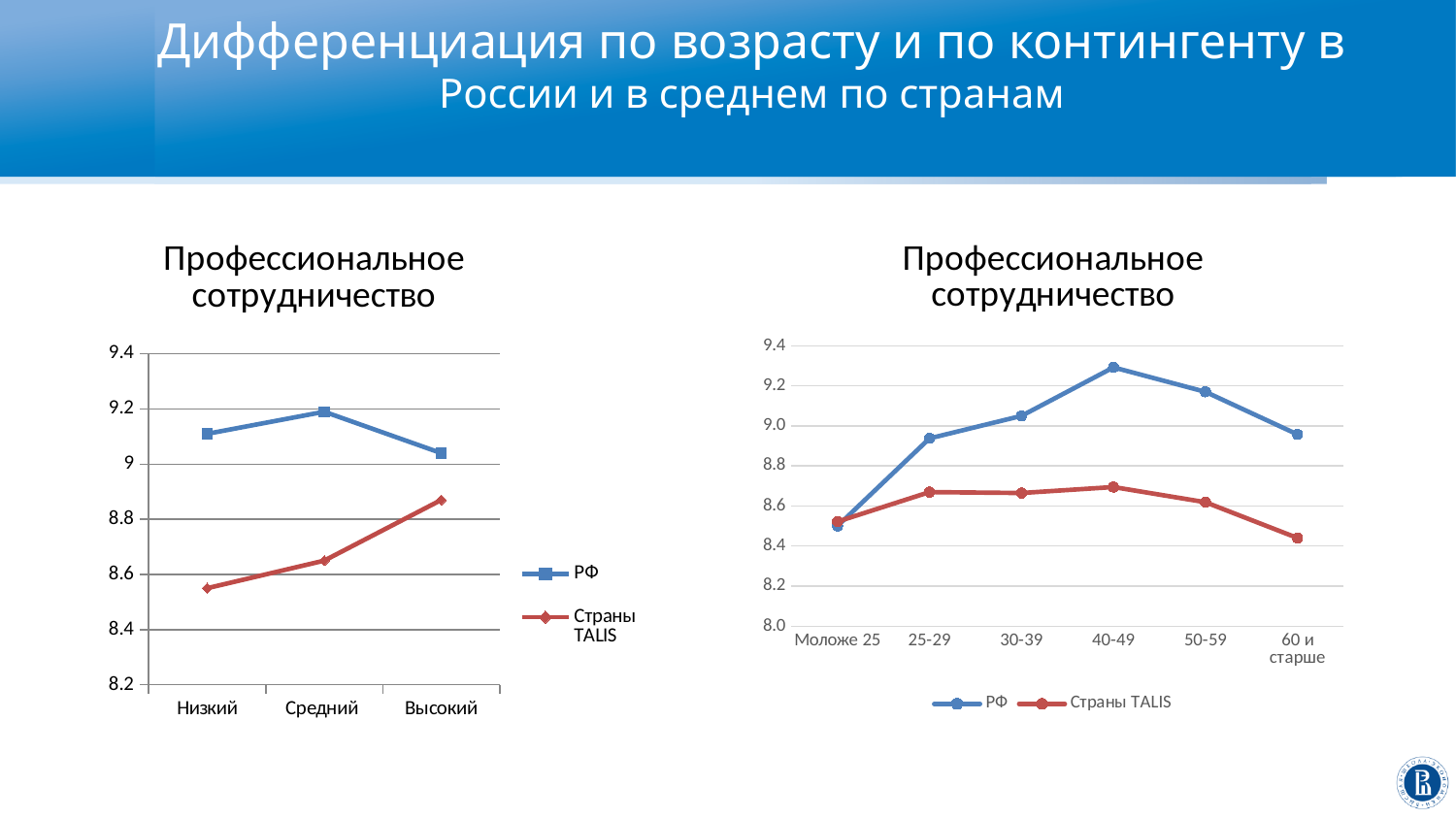
In the left chart, which category has the highest value for РФ? Средний In the left chart, does the Страны TALIS line rise or fall from Низкий to Высокий? rise In the left chart, which category has the lowest value for Страны TALIS? Низкий What type of chart is the left chart on the slide? line chart How many series does the legend of the right chart list? 2 In the left chart, is the value for Страны TALIS in the Низкий category greater or less than 8.6? less In the right chart, which series has the larger value for the 30-39 group, РФ or Страны TALIS? РФ In the right chart, which age group has the lowest value for Страны TALIS? 60 и старше In the right chart, which age group has the highest value for РФ? 40-49 How many categories are shown on the x axis of the right chart? 6 In the right chart, is the value for РФ in the 40-49 group greater or less than 9.2? greater How many categories are shown on the x axis of the left chart? 3